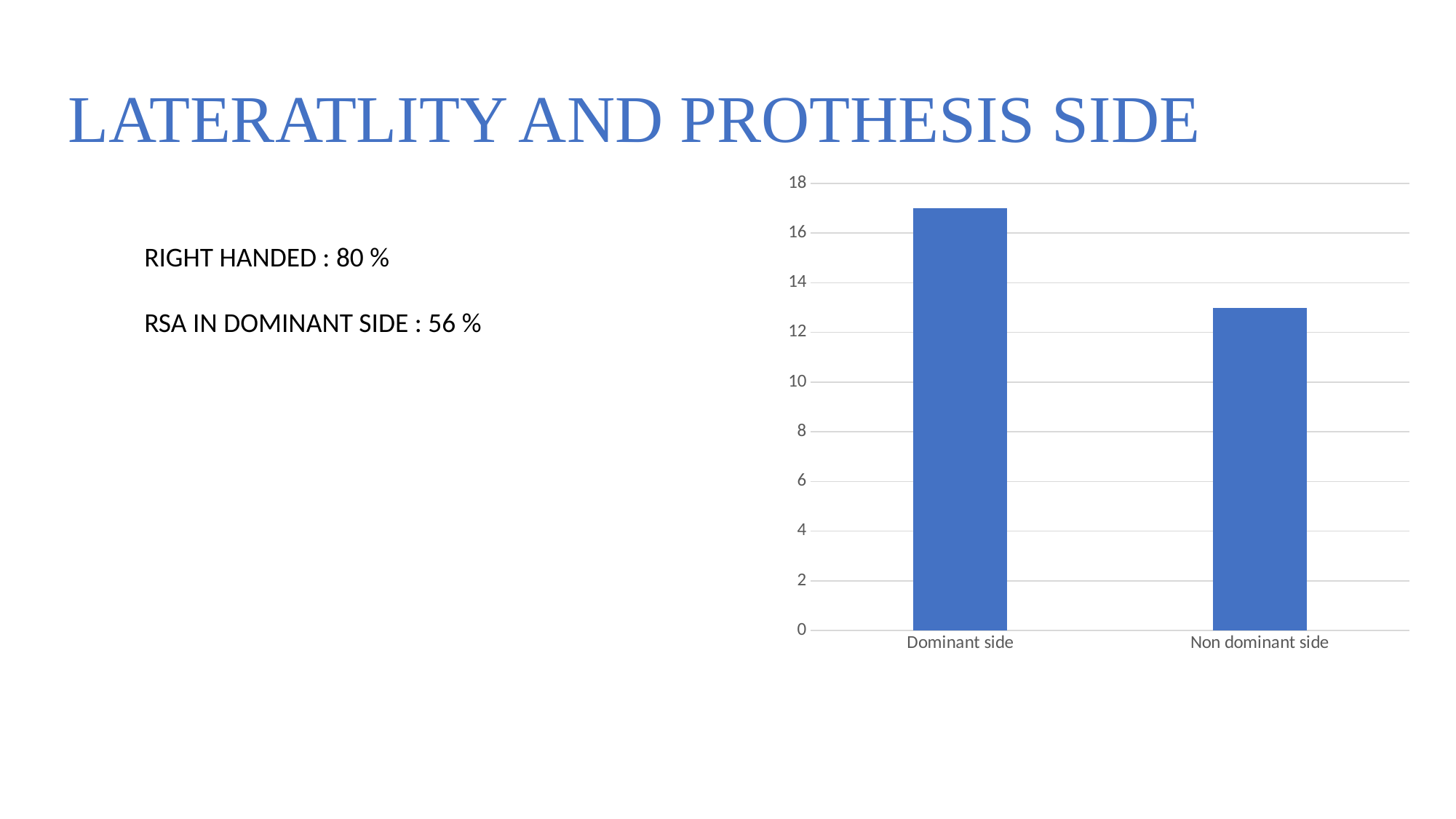
Which category has the lowest bar? Non dominant side How many categories are plotted on the chart? 2 Which is larger, the value for Dominant side or the value for Non dominant side? Dominant side Is the value for Non dominant side greater or less than 12? greater Is the value for Dominant side greater or less than 16? greater Which category has the highest bar? Dominant side What is the highest value shown on the vertical axis of the chart? 18 What kind of chart is shown on the slide? bar chart Is the value for Non dominant side greater or less than 14? less What colour are the bars in the chart? blue